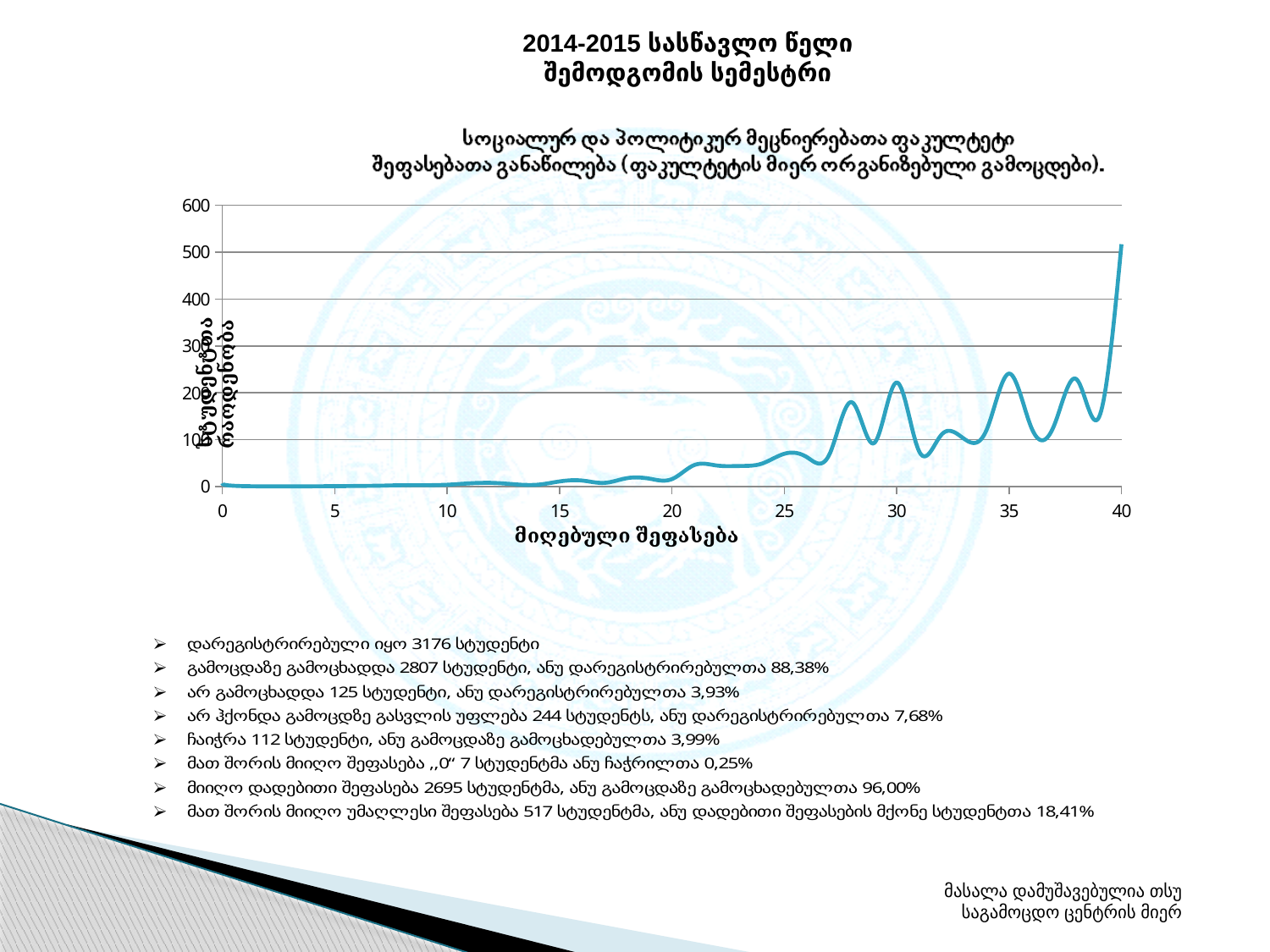
What is the highest value shown on the y-axis of the chart? 600 Is the value of the line at x = 25 greater or less than 100? less Overall, does the line rise or fall as the x-axis value increases from 0 to 40? rise Which has the larger value on the line: x = 28 or x = 25? x = 28 Is the value of the line at x = 10 greater or less than 100? less Is the value of the line at x = 35 greater or less than 200? greater Which has the larger value on the line: x = 40 or x = 35? x = 40 What is the highest value shown on the x-axis of the chart? 40 At which x-axis value (received grade) does the line reach its highest point? 40 What kind of chart is shown on the slide? line chart